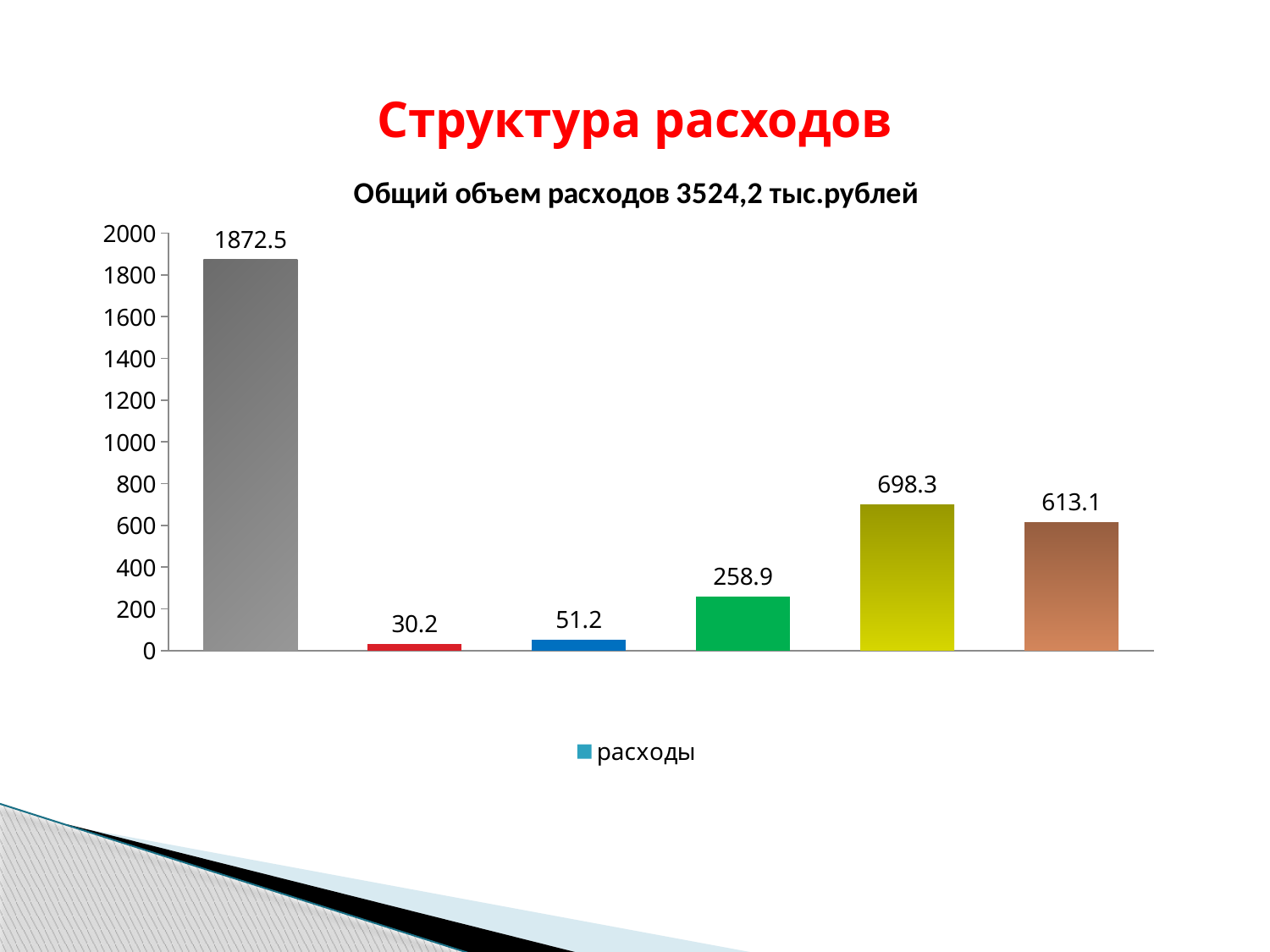
What is the value of the second (red) bar? 30.2 What is the value of the last (brown) bar on the right? 613.1 What is the value of the first (grey) bar on the left? 1872.5 How many series does the legend list? 1 What is the value of the green bar? 258.9 What is the difference between the yellow bar (698.3) and the brown bar (613.1)? 85.2 What is the value of the yellow bar? 698.3 How many bars are plotted in the chart? 6 What is the chart's title? Общий объем расходов 3524,2 тыс.рублей Which bar has the lowest value? the second (red) bar, 30.2 Which is larger, the blue bar or the green bar? the green bar What kind of chart is shown on the slide? bar chart